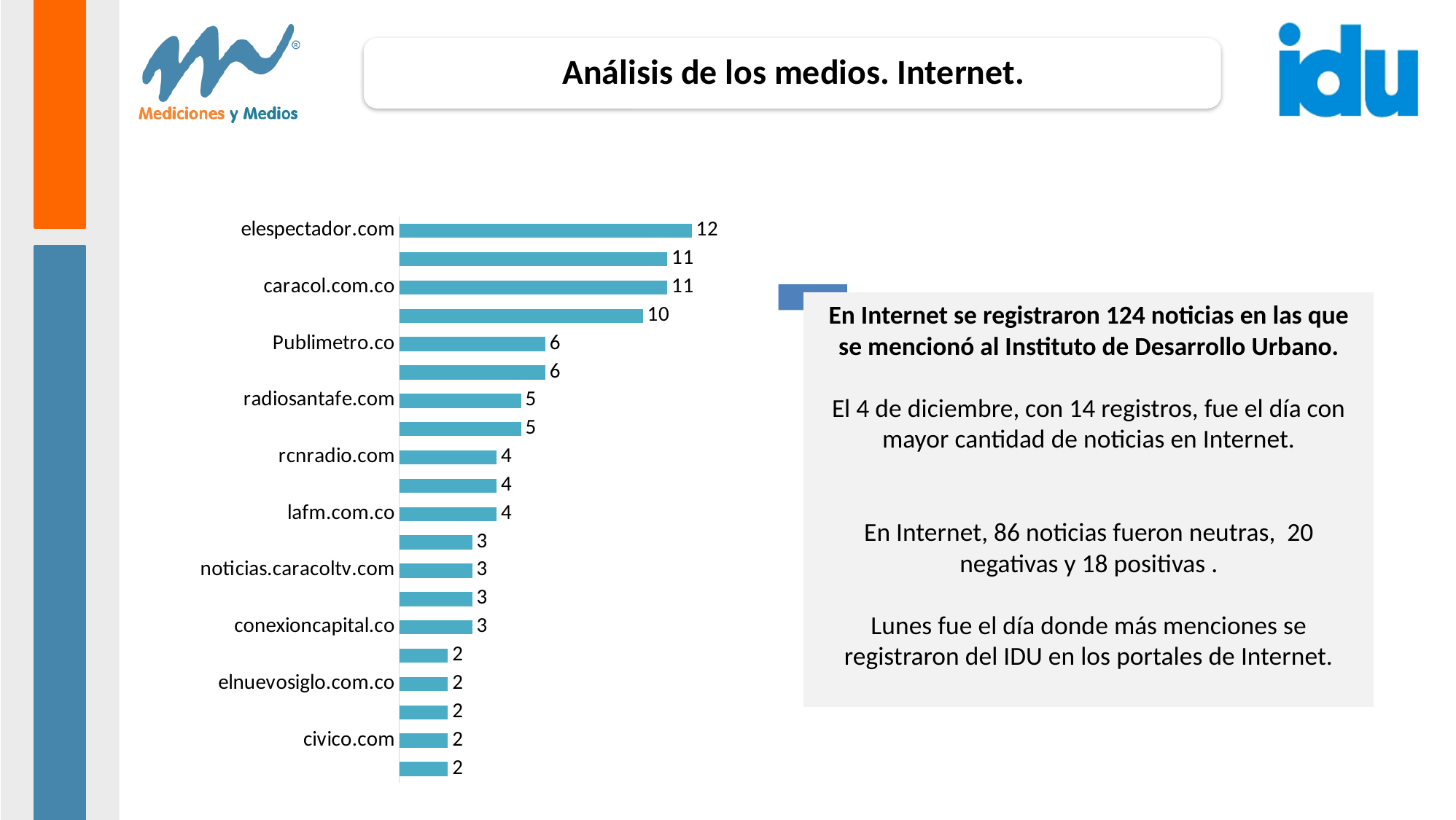
What is the value for Publimetro.co? 6 What is the value for noticias.caracoltv.com? 3 What is the difference between the values for elespectador.com and caracol.com.co? 1 What is the difference between the values for elespectador.com and Publimetro.co? 6 How many bars are plotted in the chart? 20 What is the value for radiosantafe.com? 5 Which labelled site has the highest value? elespectador.com Which has a larger value, caracol.com.co or rcnradio.com? caracol.com.co What type of chart is shown on the slide? Bar chart What is the value for caracol.com.co? 11 What is the value for elespectador.com? 12 What is the value for civico.com? 2